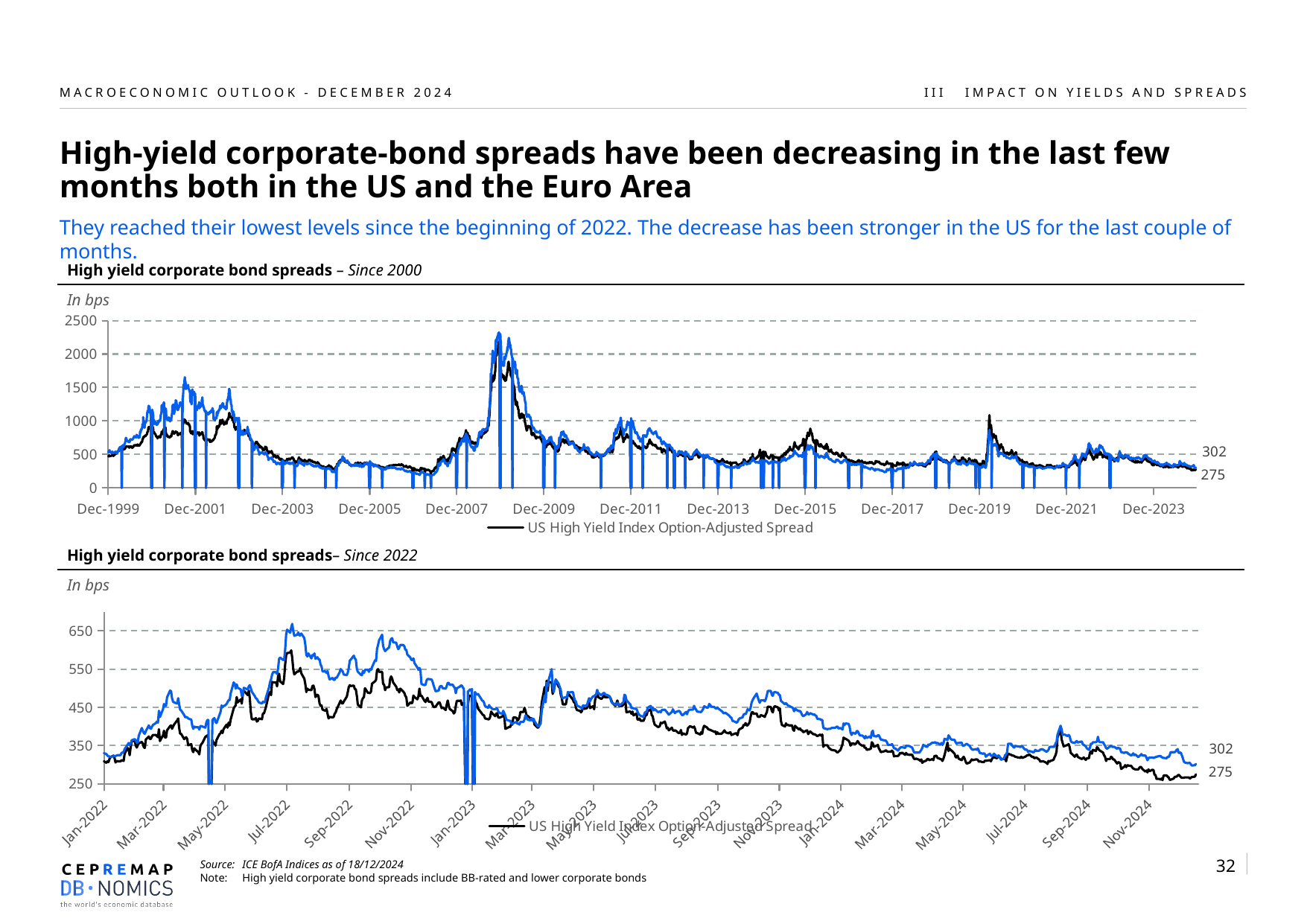
What is the first x-axis label on the top chart (Since 2000)? Dec-1999 In the top chart (Since 2000), is the peak of the black US line around Dec-2008 greater or less than 1500? greater In the bottom chart (Since 2022), which line ends at a higher value, the black US line or the blue line? the blue line In the bottom chart (Since 2022), what is the final value labelled for the blue line? 302 In the bottom chart (Since 2022), does the black US line rise or fall between Sep-2024 and the end of the series? fall In the bottom chart (Since 2022), what is the final value labelled for the US High Yield Index Option-Adjusted Spread (black line)? 275 In the bottom chart (Since 2022), what is the difference between the two end-of-series labels, 302 and 275? 27 In the bottom chart (Since 2022), is the peak of the blue line around Jul-2022 greater or less than 600? greater In the top chart (Since 2000), is the peak of the blue line around Dec-2008 greater or less than 2000? greater What unit is indicated for the values in the top chart (Since 2000)? In bps What kind of chart is the top chart titled 'High yield corporate bond spreads – Since 2000'? line chart